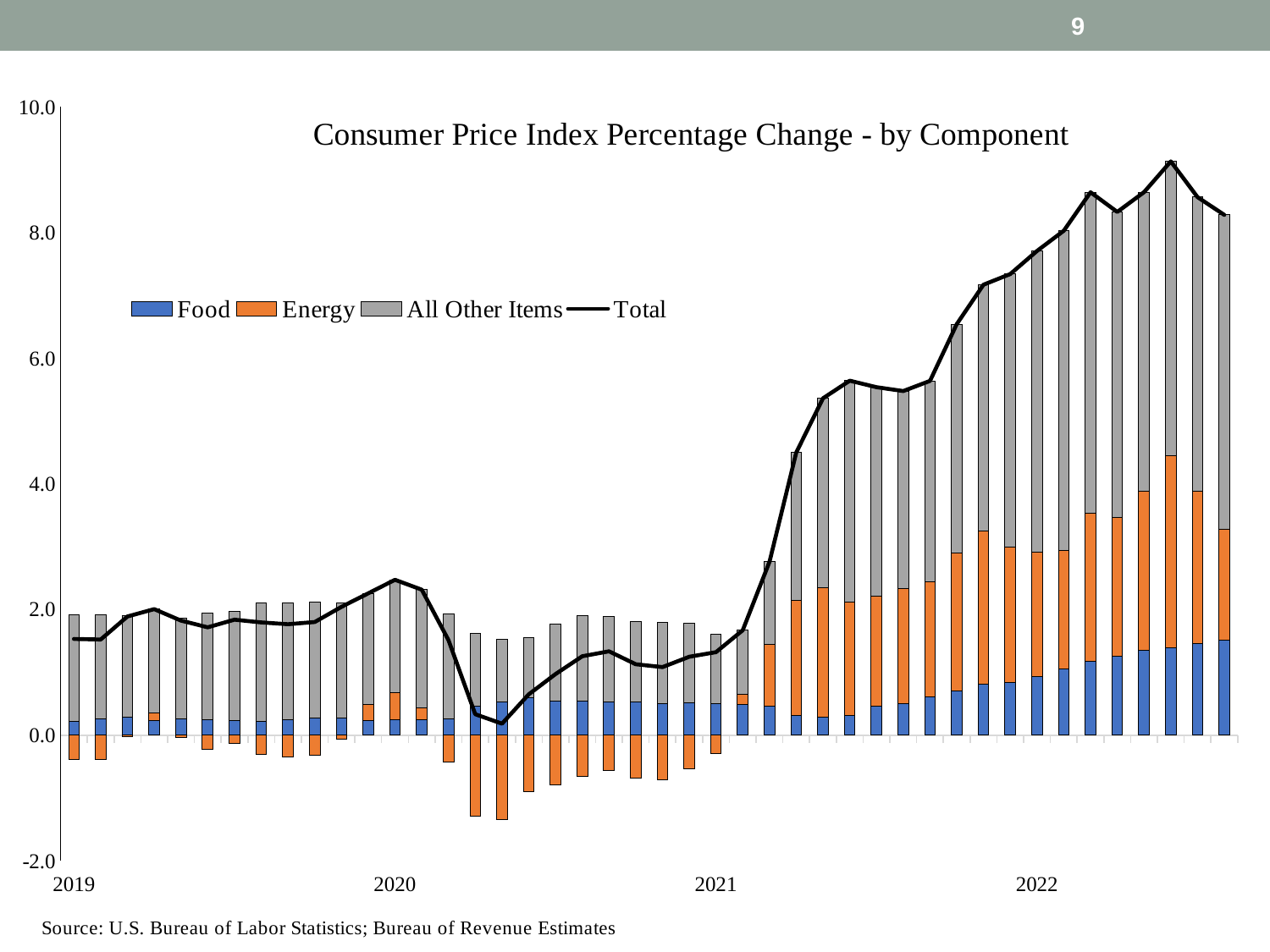
Is the lowest Total value on the chart greater or less than 2.0? less What kind of chart is shown on the slide? Stacked bar chart with a line Does the Total line rise or fall from the start of 2021 to the start of 2022? rise Is the lowest Energy value on the chart greater or less than 0.0? less Which series is drawn as a line rather than bars? Total How many series does the legend list? 4 What is the title of the chart? Consumer Price Index Percentage Change - by Component Is the Total value at the start of 2019 greater or less than 2.0? less In which year labelled on the x axis does the Total line reach its highest point? 2022 In which year labelled on the x axis does the Total line reach its lowest point? 2020 Which is larger, the Total value at the start of 2019 or the Total value at the start of 2022? 2022